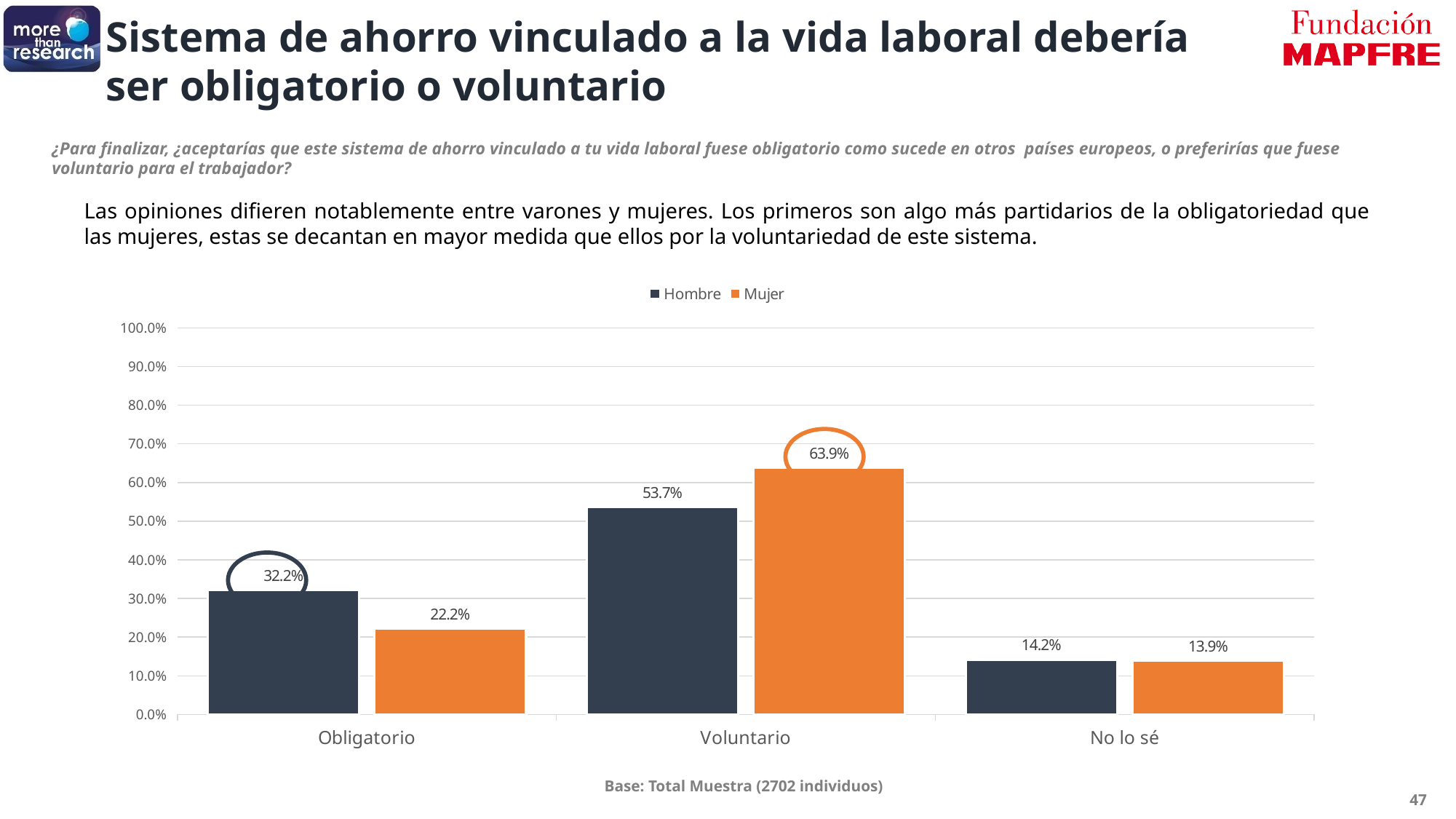
How many series does the legend list? 2 Is the value for Hombre in the Voluntario category greater or less than 50.0%? greater Which is larger in the Obligatorio category, the Hombre value or the Mujer value? Hombre What is the value for Mujer in the Voluntario category? 63.9% How many categories are shown on the x axis? 3 Which category has the highest value for the Hombre series? Voluntario What is the difference between the Mujer and Hombre values in the Voluntario category? 10.2% What is the value for Mujer in the No lo sé category? 13.9% What kind of chart is shown on the slide? Bar chart Which category has the lowest value for the Mujer series? No lo sé What is the value for Hombre in the Obligatorio category? 32.2% What is the difference between the Hombre and Mujer values in the Obligatorio category? 10.0%